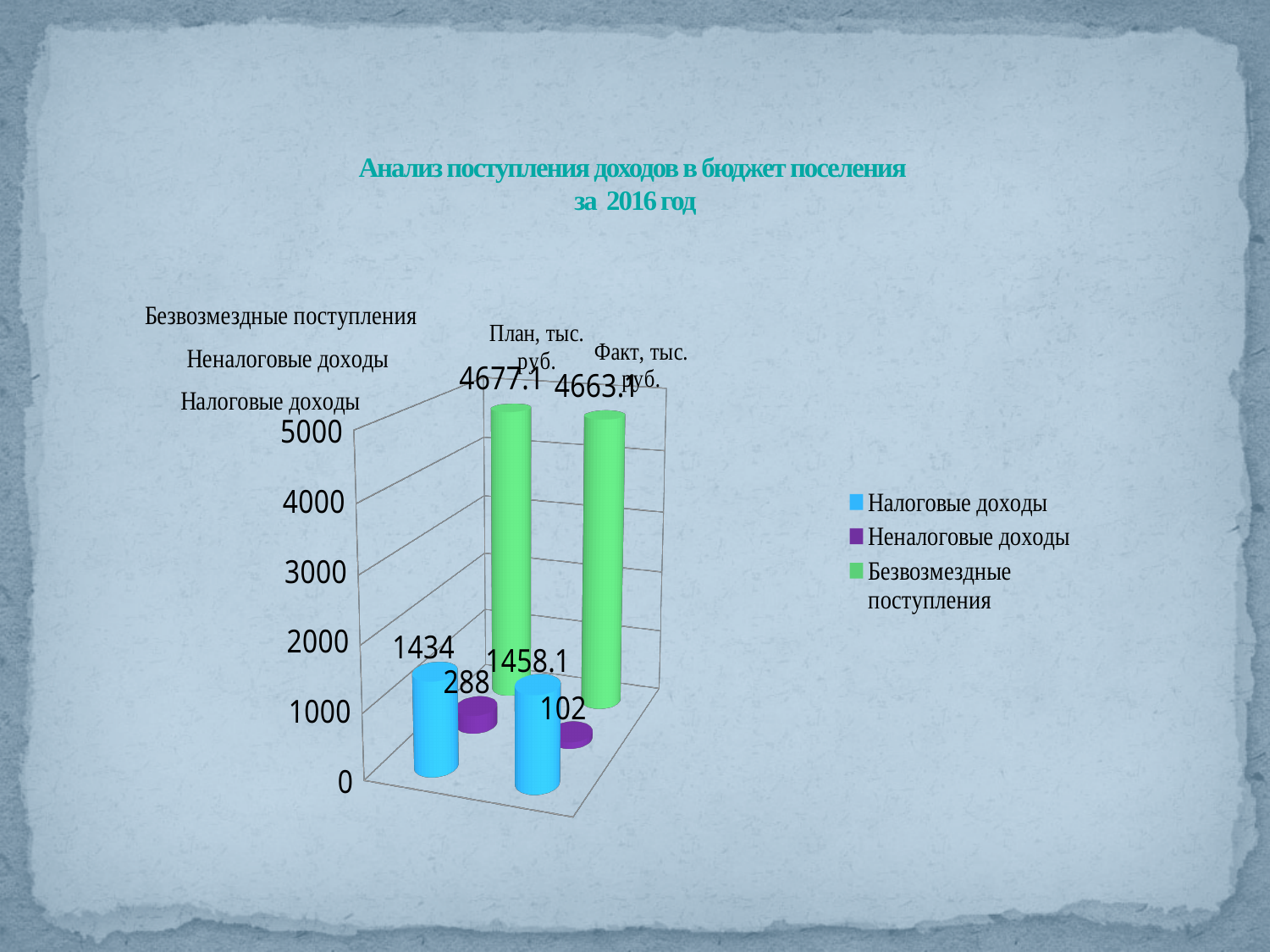
What is the value of Налоговые доходы for План, тыс. руб.? 1434 What kind of chart is shown on the slide? bar chart What is the value of Безвозмездные поступления for Факт, тыс. руб.? 4663.1 Which is larger: Налоговые доходы for План or Налоговые доходы for Факт? Факт What is the value of Безвозмездные поступления for План, тыс. руб.? 4677.1 How many series does the legend list? 3 What is the value of Неналоговые доходы for План, тыс. руб.? 288 Which series has the highest value for Факт, тыс. руб.? Безвозмездные поступления What is the value of Налоговые доходы for Факт, тыс. руб.? 1458.1 Which series has the lowest value for План, тыс. руб.? Неналоговые доходы What is the value of Неналоговые доходы for Факт, тыс. руб.? 102 What is the difference between the План and Факт values for Неналоговые доходы? 186